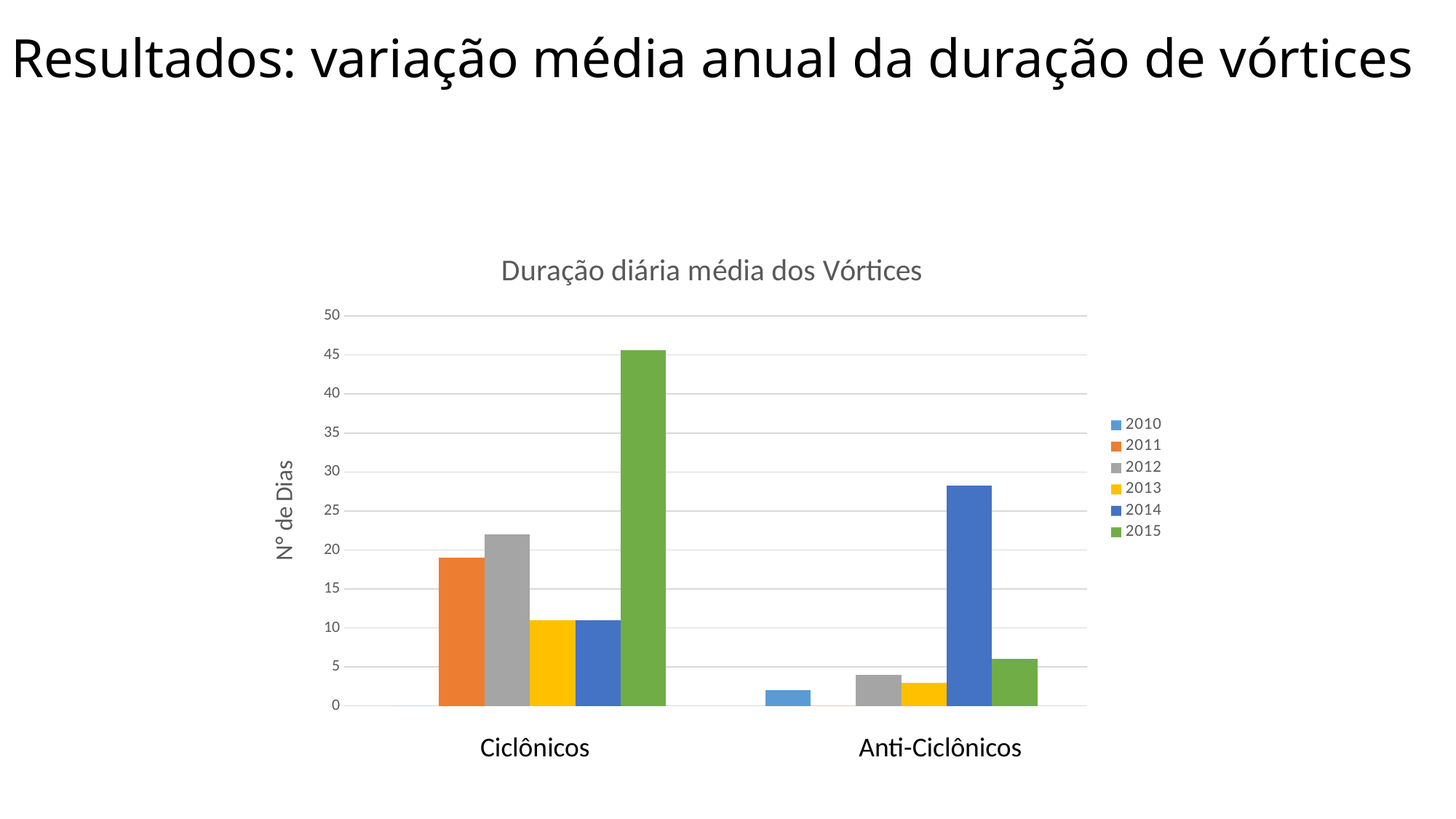
Is the value for 2015 in the Anti-Ciclônicos category greater or less than 10? less How many series does the legend list? 6 Is the value for 2011 in the Ciclônicos category greater or less than 15? greater What kind of chart is shown on the slide? bar chart Which year has the highest value for Ciclônicos? 2015 Which is larger: the 2014 value for Ciclônicos or the 2014 value for Anti-Ciclônicos? Anti-Ciclônicos Is the value for 2015 in the Ciclônicos category greater or less than 40? greater What is the title of the chart? Duração diária média dos Vórtices Which year has the highest value for Anti-Ciclônicos? 2014 Which is larger for Ciclônicos: the 2011 value or the 2012 value? 2012 How many categories are shown on the x axis? 2